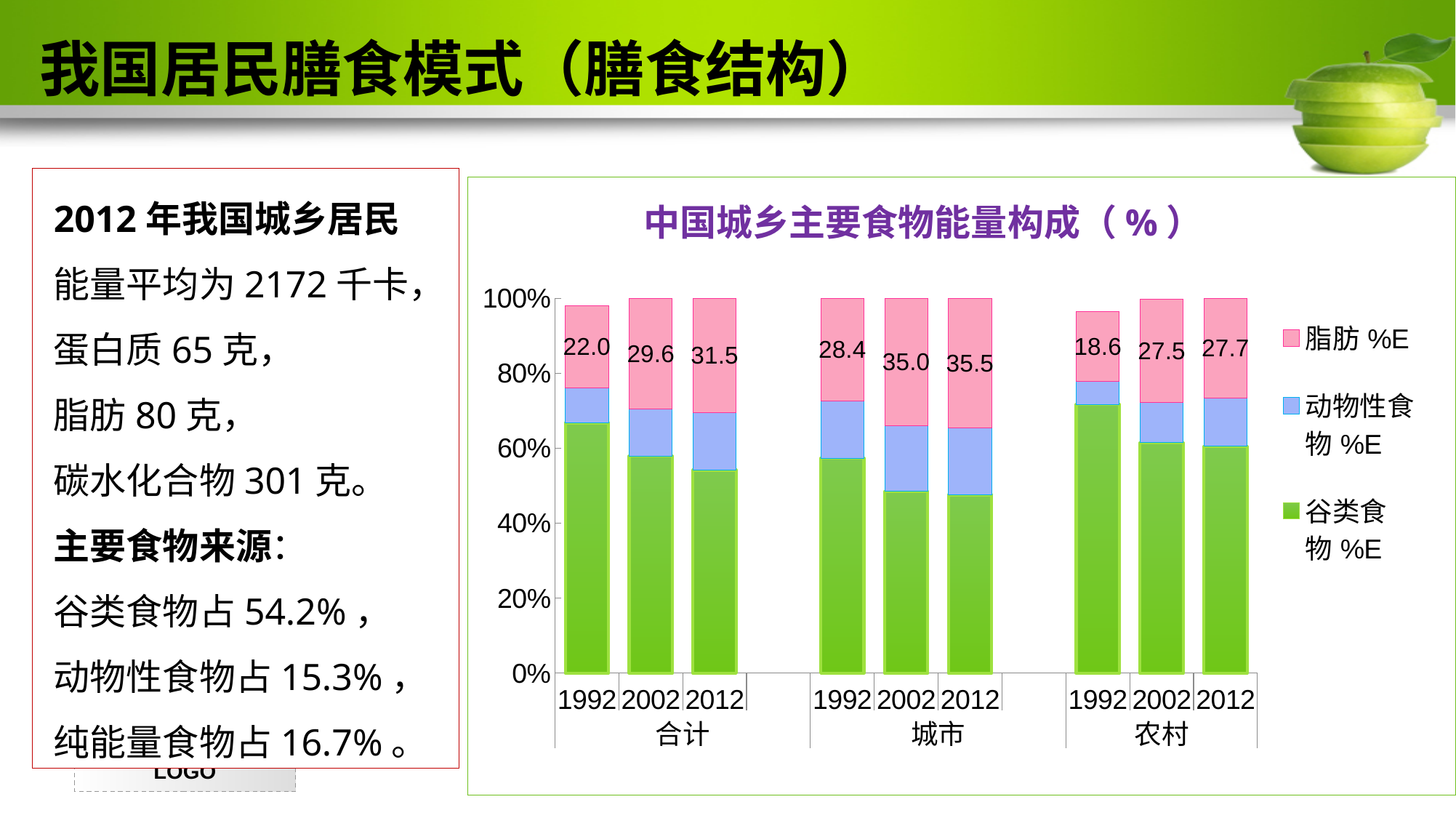
Is the 谷类食物 %E value for 合计 in 1992 greater or less than 60%? greater How many series does the legend list? 3 Which is larger, the 脂肪 %E value for 城市 in 1992 or for 农村 in 2002? 城市 1992 Which bar has the lowest 脂肪 %E value? 农村 1992 What is the 脂肪 %E value for 城市 in 2002? 35.0 What is the 脂肪 %E value for 合计 in 1992? 22.0 Which bar has the highest 脂肪 %E value? 城市 2012 Is the 谷类食物 %E value for 城市 in 2012 greater or less than 60%? less What is the 脂肪 %E value for 农村 in 2012? 27.7 What is the difference between the 脂肪 %E values for 合计 in 2012 and 合计 in 1992? 9.5 How many bars are plotted in the chart? 9 What kind of chart is shown on the slide? Stacked bar chart